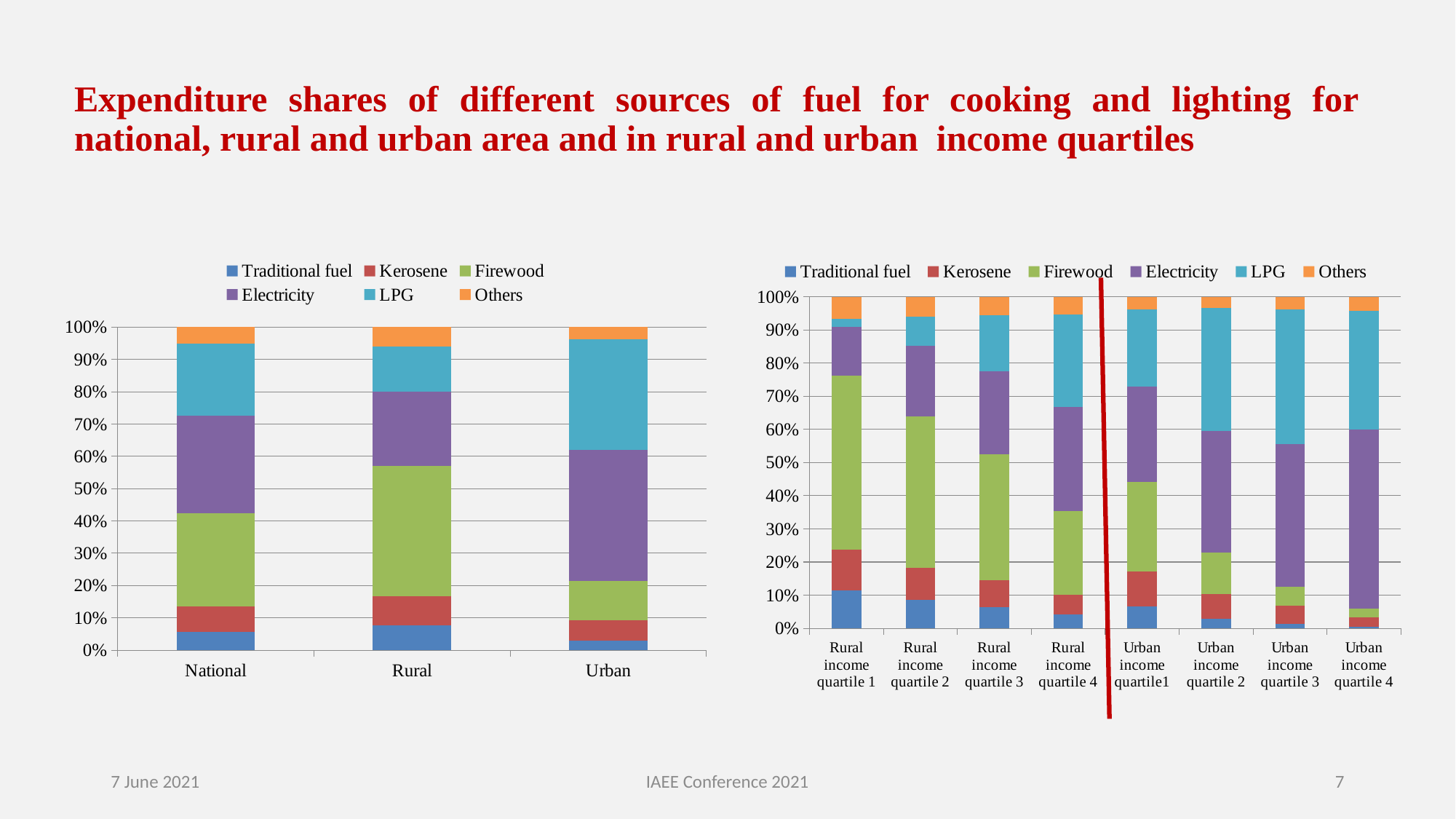
In the left chart, is the top of the Firewood segment for Rural greater or less than 50%? greater In the right chart, is the Firewood segment larger for Rural income quartile 1 or for Urban income quartile 4? Rural income quartile 1 In the right chart, is the top of the Firewood segment for Rural income quartile 1 greater or less than 70%? greater In the left chart, which category has the largest Firewood segment? Rural In the right chart, does the LPG share rise or fall from Urban income quartile1 to Urban income quartile 4? Rise What kind of chart is the left chart (National, Rural, Urban)? Stacked bar chart What are the six legend entries of the right chart? Traditional fuel, Kerosene, Firewood, Electricity, LPG, Others In the right chart, does the Firewood share rise or fall from Rural income quartile 1 to Rural income quartile 4? Fall In the left chart, is the Electricity segment larger for Urban or for Rural? Urban How many categories are shown on the x axis of the right chart? 8 How many series does the legend of the left chart list? 6 In the left chart, which category has the largest LPG segment? Urban